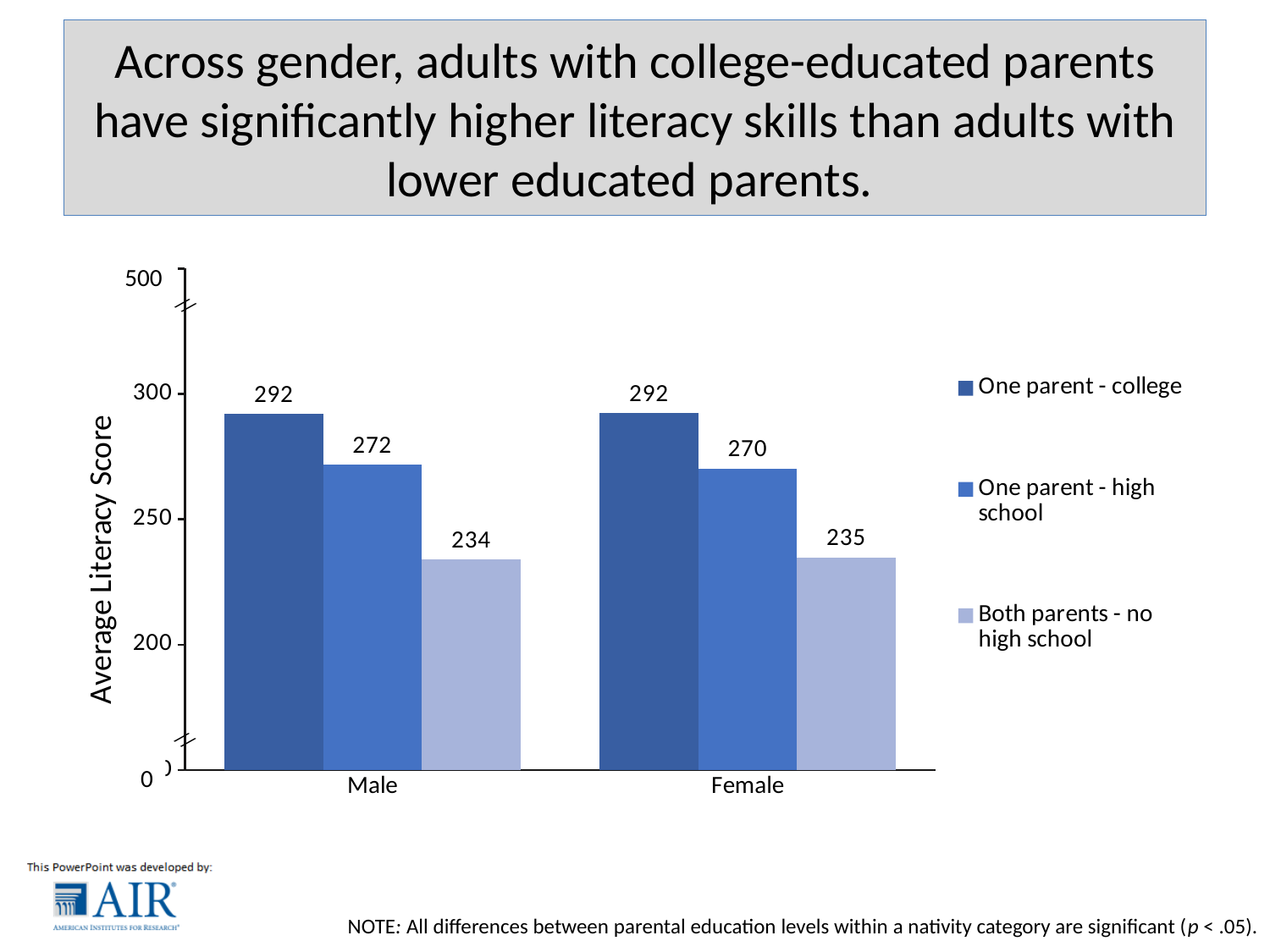
What is the average literacy score for Male adults with one parent who attended college? 292 Which parental education group has the lowest average literacy score among Male adults? Both parents - no high school What kind of chart is shown on the slide? Bar chart What is the difference in average literacy score between Male adults with one parent - college and Male adults with both parents - no high school? 58 Which is larger: the average literacy score for Male adults with one parent - high school or Female adults with one parent - high school? Male Which parental education group has the highest average literacy score among Female adults? One parent - college What is the difference in average literacy score between Female adults with one parent - college and Female adults with one parent - high school? 22 What is the label of the y axis? Average Literacy Score What is the average literacy score for Female adults with one parent who attended high school? 270 How many series does the legend list? 3 What is the average literacy score for Female adults with both parents having no high school education? 235 How many gender categories are shown on the x axis? 2